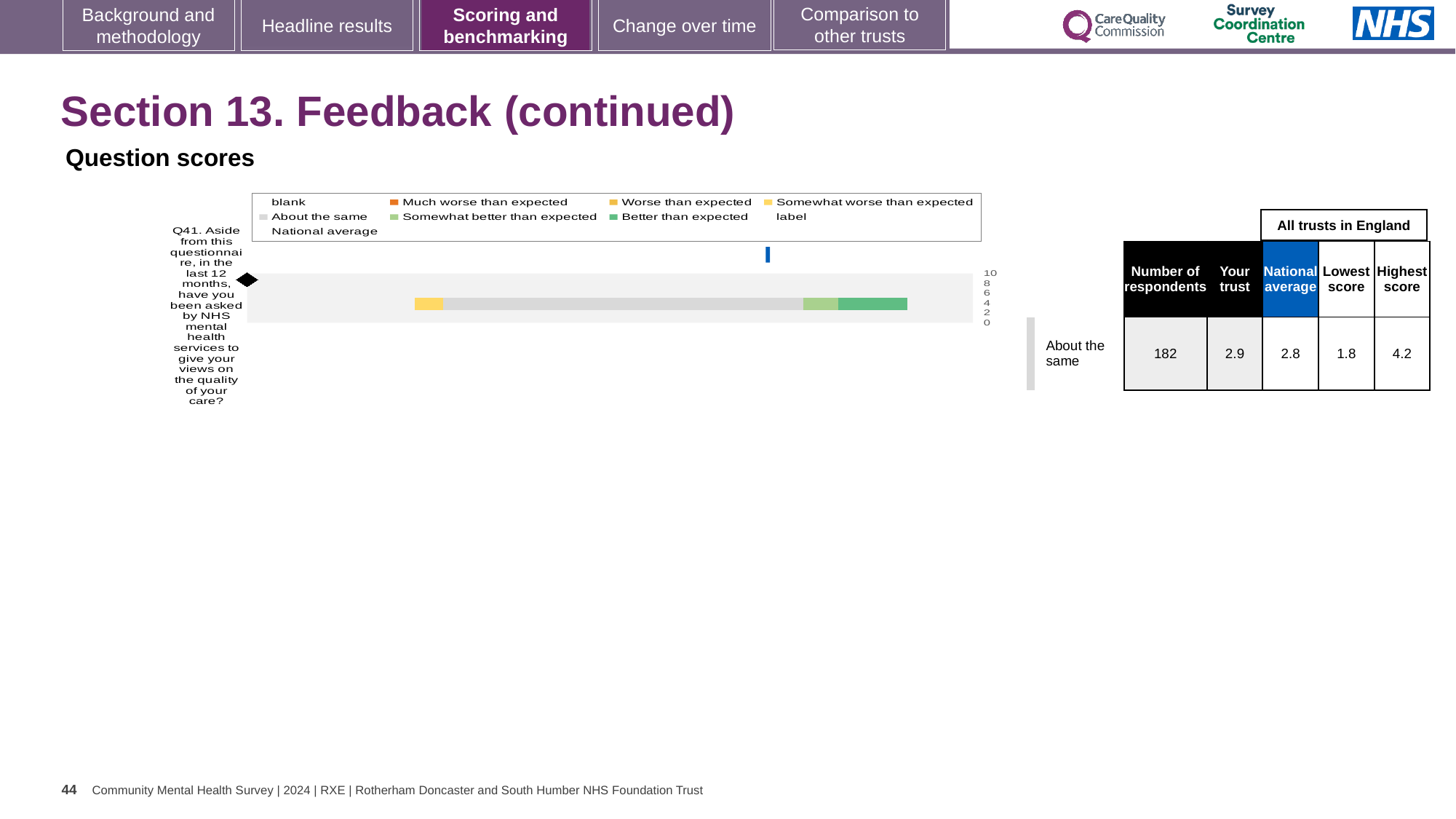
Which legend entry is shown in dark green in the chart? Better than expected How many survey questions are plotted in the chart? 1 What kind of chart is shown on the slide? bar chart For Q41, what is the difference between the highest score and the lowest score among all trusts in England? 2.4 In the table beside the chart, what is the number of respondents for Q41? 182 According to the label beside the chart, which category does the trust's score for Q41 fall into? About the same In the table beside the chart, what is the national average score for Q41? 2.8 In the table beside the chart, what is the highest score among all trusts in England for Q41? 4.2 Which question number is plotted in the chart? Q41 In the table beside the chart, what is the 'Your trust' score for Q41? 2.9 In the table beside the chart, what is the lowest score among all trusts in England for Q41? 1.8 For Q41, is the 'Your trust' score higher or lower than the national average? higher